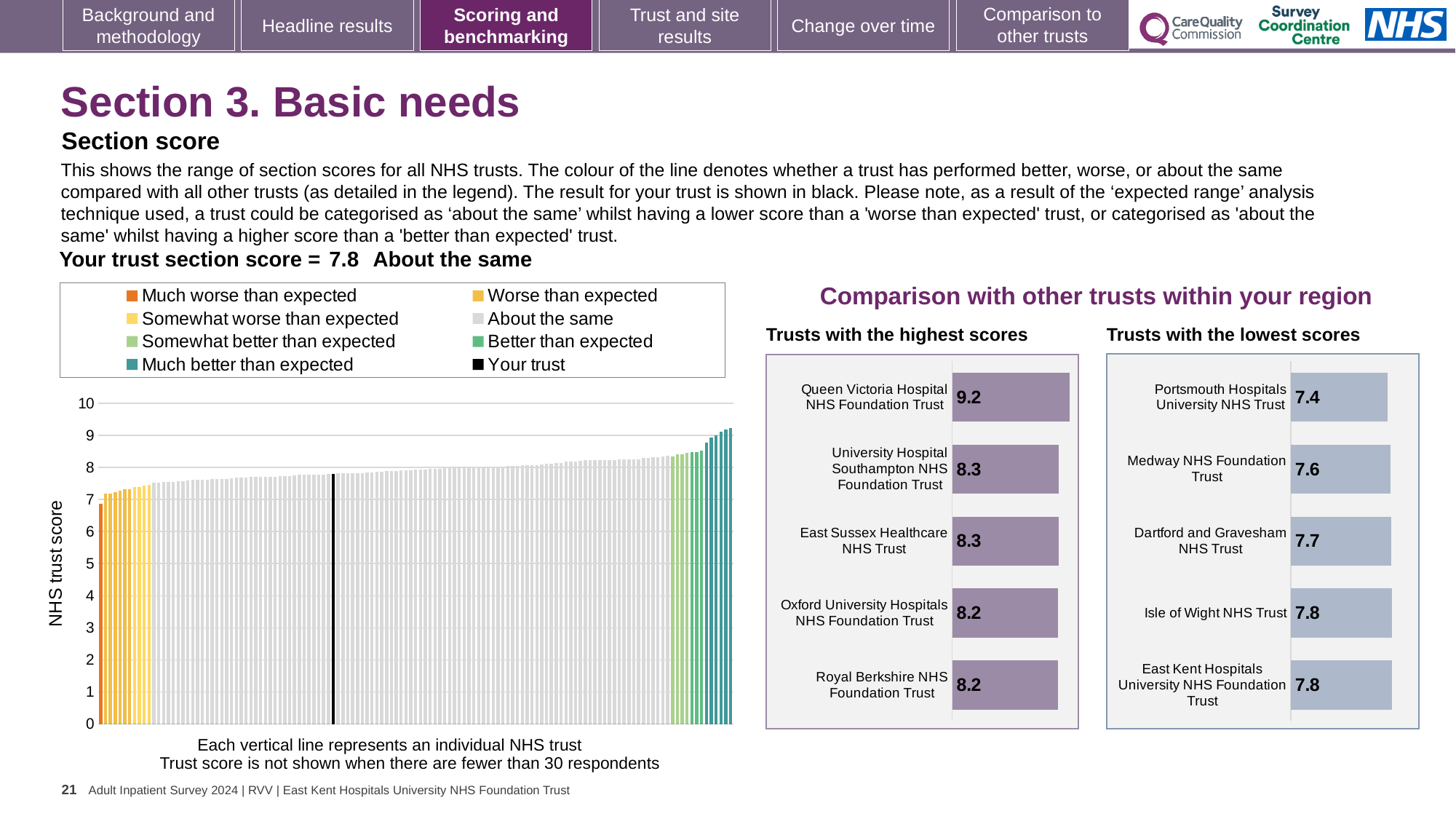
In the 'Trusts with the lowest scores' chart, what is the score for East Kent Hospitals University NHS Foundation Trust? 7.8 In the 'Trusts with the highest scores' chart, what is the score for Queen Victoria Hospital NHS Foundation Trust? 9.2 In the 'Trusts with the lowest scores' chart, what is the score for Portsmouth Hospitals University NHS Trust? 7.4 In the 'Trusts with the lowest scores' chart, which has the larger score: Medway NHS Foundation Trust or Dartford and Gravesham NHS Trust? Dartford and Gravesham NHS Trust In the main chart on the left, is the value of the rightmost bar greater or less than 9? greater In the main chart on the left, do the trust scores rise or fall from left to right? Rise How many trusts are shown in the 'Trusts with the highest scores' chart? 5 In the 'Trusts with the highest scores' chart, which trust has the highest score? Queen Victoria Hospital NHS Foundation Trust In the 'Trusts with the lowest scores' chart, which trust has the lowest score? Portsmouth Hospitals University NHS Trust In the main chart on the left showing all NHS trusts, how many entries does the legend list? 8 What kind of chart is the main chart on the left showing NHS trust scores? Bar chart In the 'Trusts with the highest scores' chart, what is the difference between the scores of Queen Victoria Hospital NHS Foundation Trust and Royal Berkshire NHS Foundation Trust? 1.0